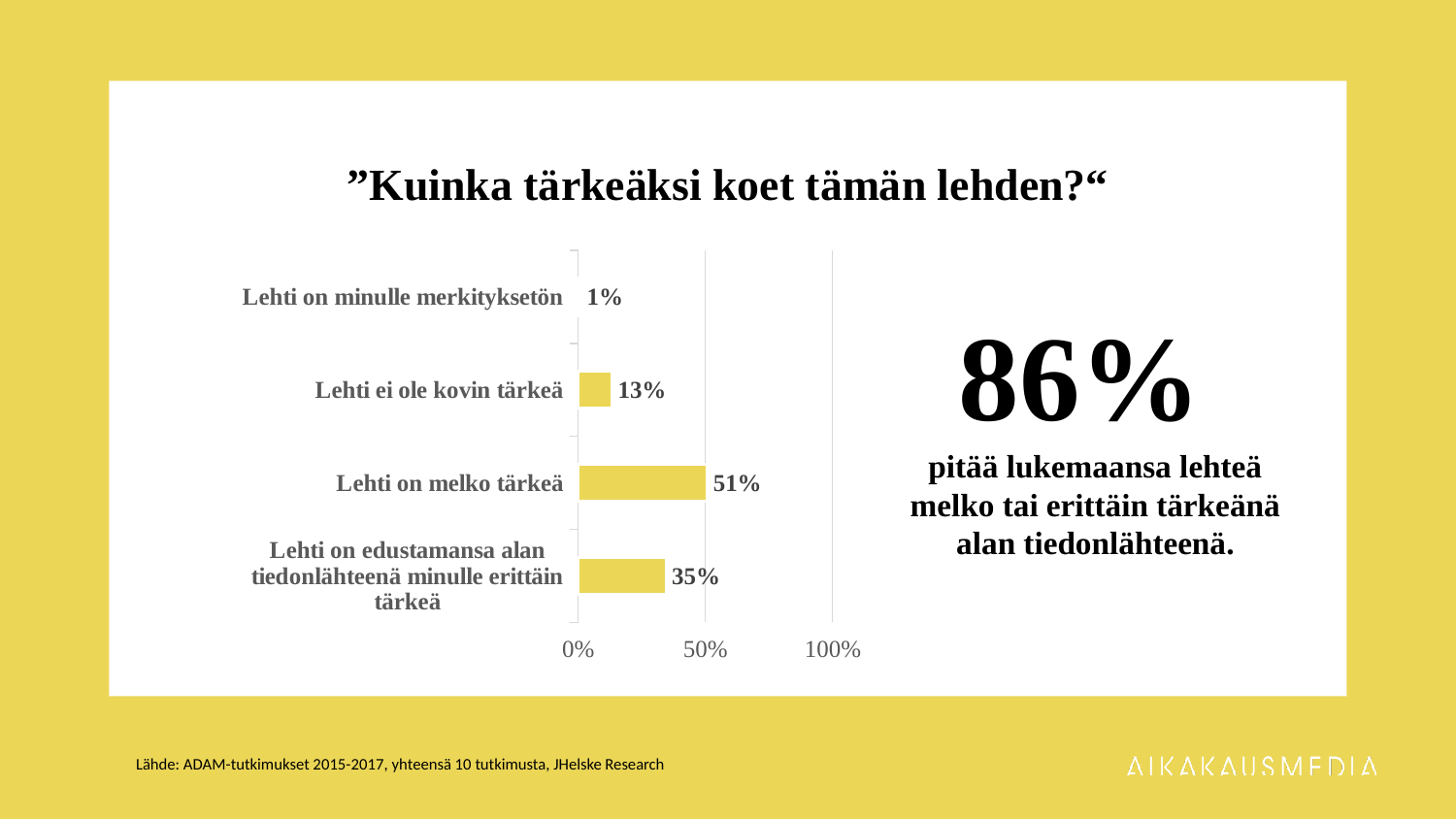
What is the value for "Lehti on edustamansa alan tiedonlähteenä minulle erittäin tärkeä"? 35% What is the title of the chart? "Kuinka tärkeäksi koet tämän lehden?" What is the value for "Lehti ei ole kovin tärkeä"? 13% What is the difference between "Lehti on melko tärkeä" and "Lehti on edustamansa alan tiedonlähteenä minulle erittäin tärkeä"? 16% Which category has the highest value? Lehti on melko tärkeä How many categories are shown in the chart? 4 Is the value for "Lehti on melko tärkeä" greater or less than 50%? greater Which category has the lowest value? Lehti on minulle merkityksetön Which is larger, the value for "Lehti ei ole kovin tärkeä" or for "Lehti on edustamansa alan tiedonlähteenä minulle erittäin tärkeä"? Lehti on edustamansa alan tiedonlähteenä minulle erittäin tärkeä What is the value for "Lehti on minulle merkityksetön"? 1% What percentage of respondents answered "Lehti on melko tärkeä"? 51% What kind of chart is shown on the slide? Bar chart